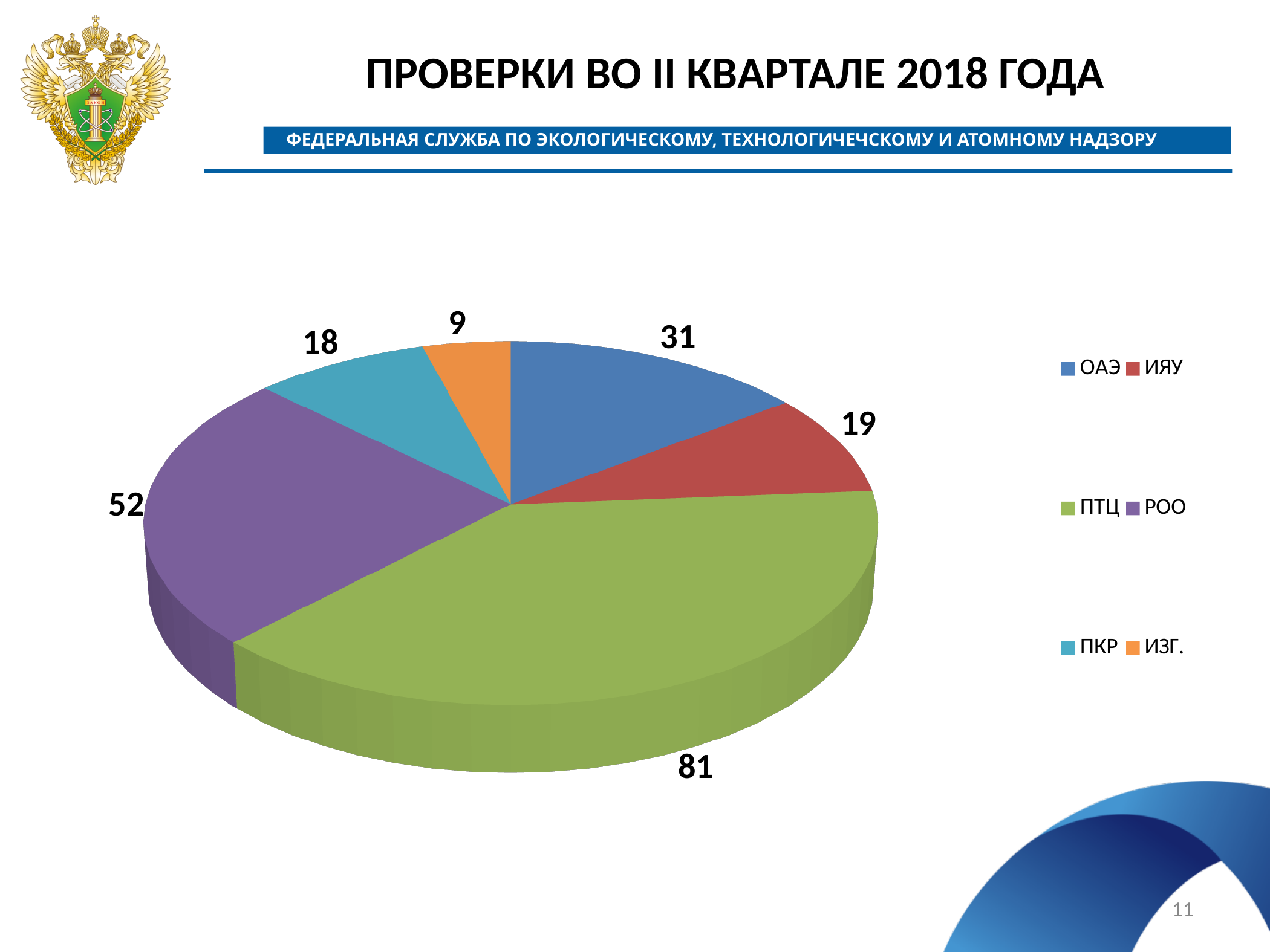
What is the value for ОАЭ in the pie chart? 31 What is the value for ПТЦ in the pie chart? 81 What is the difference between the values for ПТЦ and РОО? 29 What is the value for ИЗГ. in the pie chart? 9 What type of chart is shown on the slide? Pie chart What is the total of all values in the pie chart? 210 What is the value for РОО in the pie chart? 52 How many categories are shown in the pie chart? 6 Which is larger, the value for ОАЭ or the value for ИЯУ? ОАЭ Which category has the largest slice in the pie chart? ПТЦ What is the title of the slide containing the pie chart? ПРОВЕРКИ ВО II КВАРТАЛЕ 2018 ГОДА Which category has the smallest slice in the pie chart? ИЗГ.